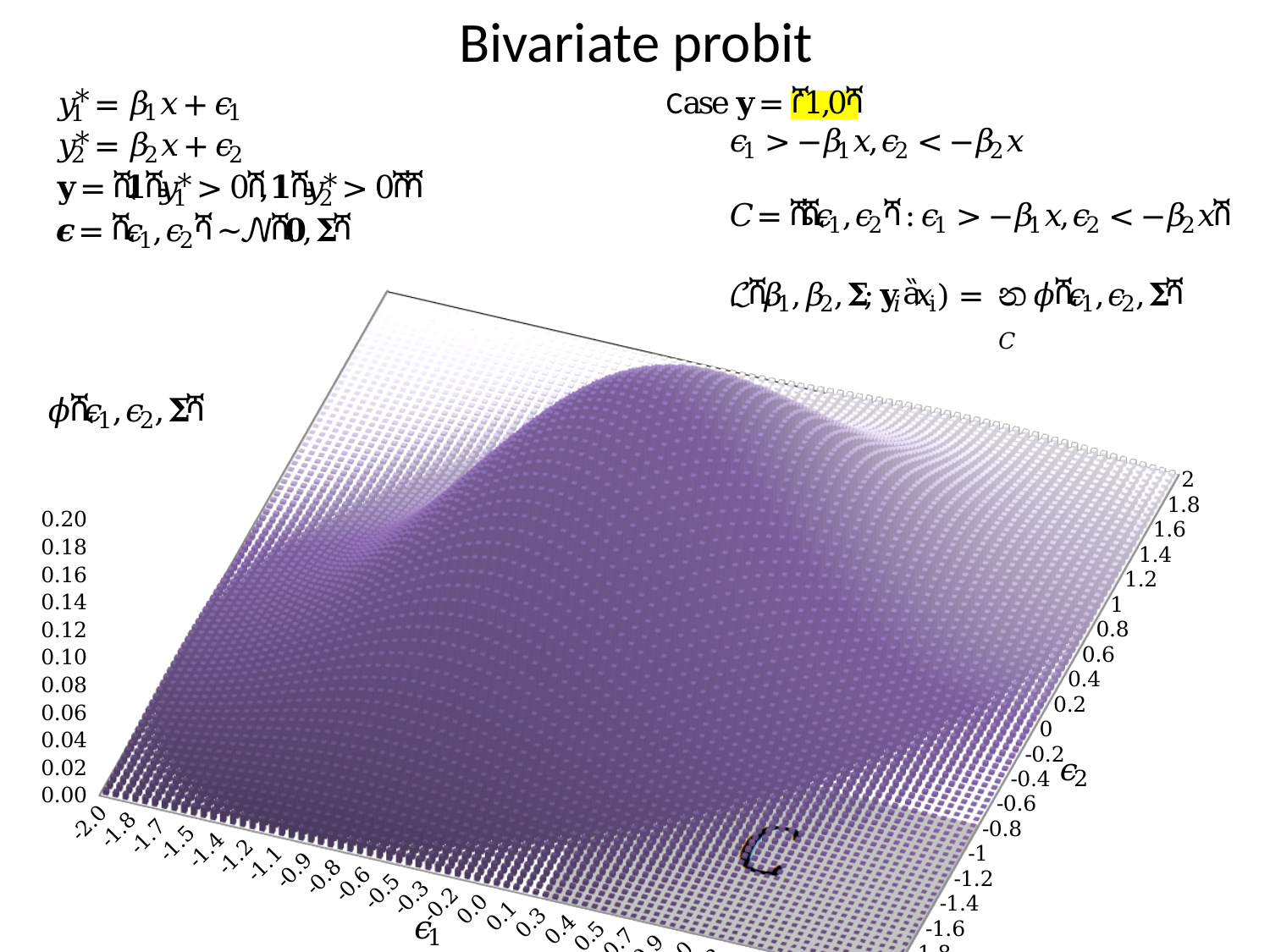
What is the step between consecutive tick labels on the ε2 axis of the surface chart? 0.2 What is the smallest tick label shown on the ε1 axis of the surface chart? -2.0 What is the lowest tick value printed on the vertical axis of the surface chart? 0.00 Is the peak of the surface greater or less than 0.02? greater Is the value of the surface at the corner ε1 = -2.0, ε2 = -1.8 greater or less than 0.10? less What is the highest tick value printed on the vertical axis of the surface chart? 0.20 What letter labels the shaded region on the floor of the surface chart? C What kind of chart is shown on the slide? 3D surface chart Does the surface rise or fall as ε1 increases from -2.0 toward 0? rise What is the step between consecutive tick labels on the vertical axis of the surface chart? 0.02 What is the largest tick label shown on the ε2 axis of the surface chart? 2